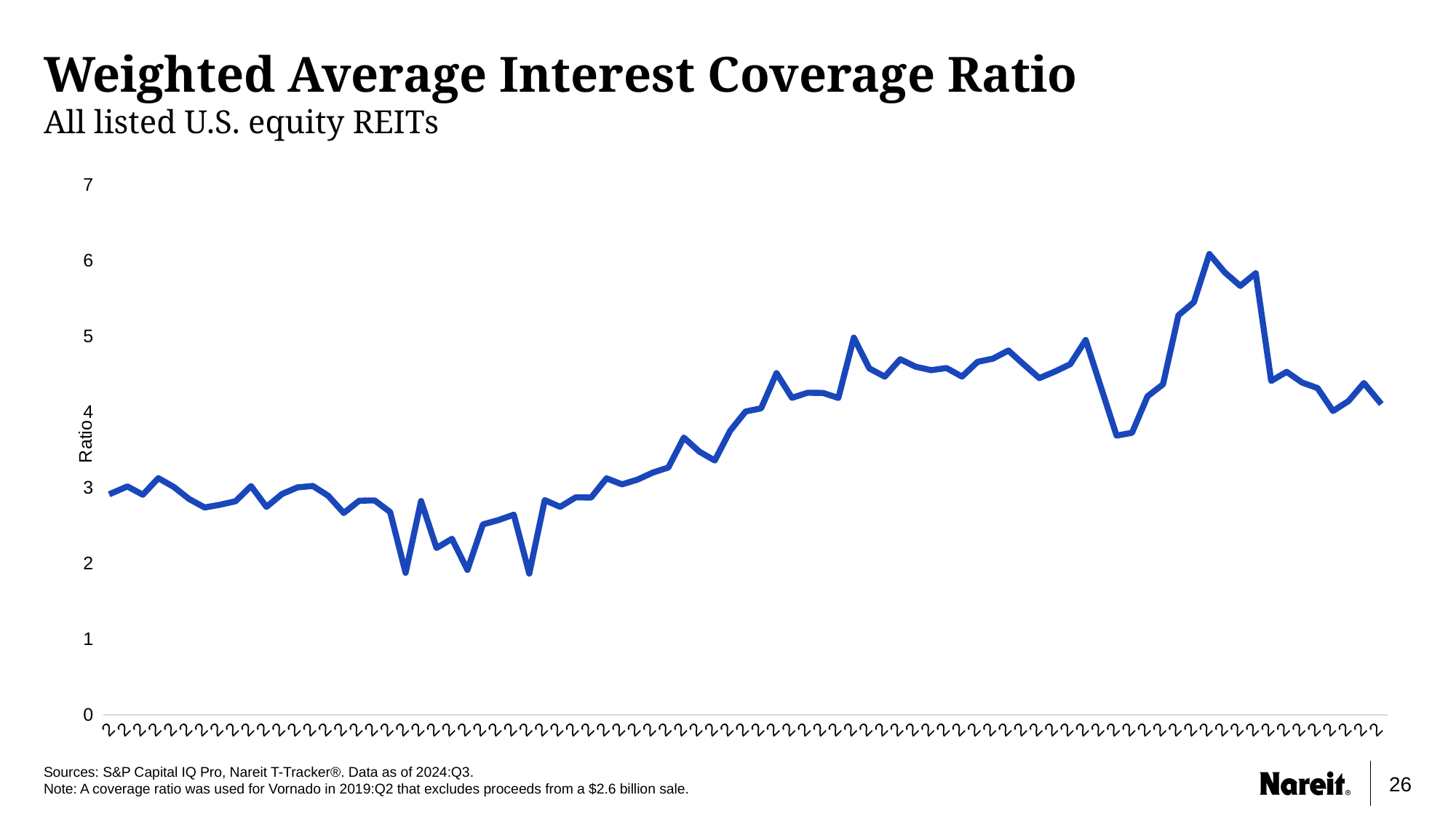
Is the value at the right end of the line higher or lower than the value at the left end? higher Is the value at the left end of the line greater or less than 4? less Overall, does the interest coverage ratio rise or fall from the left end of the chart to the right end? rise Is the lowest point on the line greater or less than 2? less What label is shown on the vertical axis of the chart? Ratio What is the highest value shown on the vertical axis? 7 Is the value at the right end of the line greater or less than 4? greater How many lines are plotted on the chart? 1 What is the title of the chart? Weighted Average Interest Coverage Ratio What kind of chart is shown on the slide? line chart